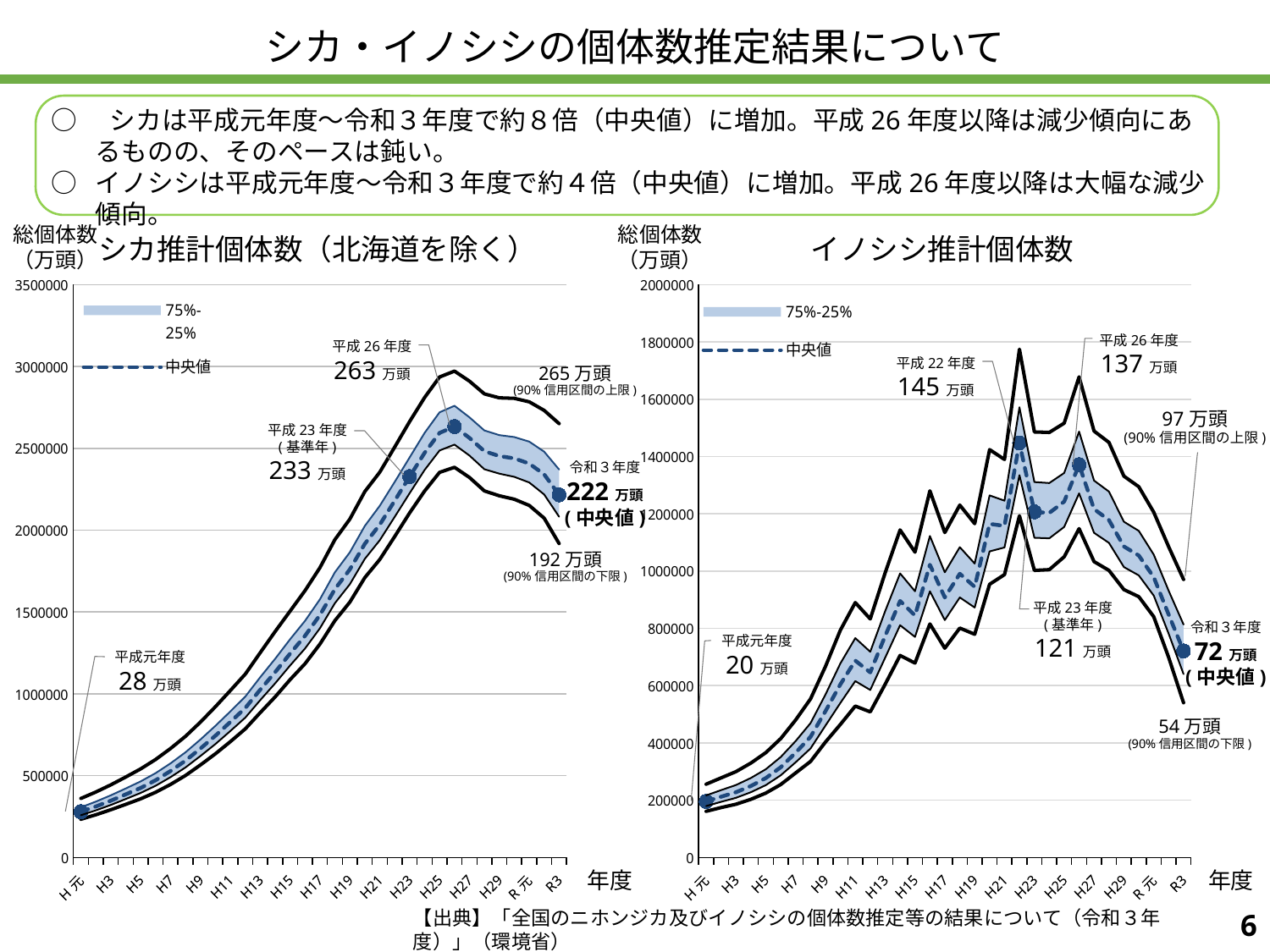
In the シカ推計個体数（北海道を除く） chart, what is the labelled median value for 平成26年度? 263 万頭 How many entries does the legend of the シカ推計個体数（北海道を除く） chart list? 2 What kind of chart is the イノシシ推計個体数 chart? Combination line and area chart (lines with a shaded 75%-25% band) In the イノシシ推計個体数 chart, what is the labelled lower limit of the 90% credible interval for 令和3年度? 54 万頭 In the イノシシ推計個体数 chart, which labelled year has the larger median value, 平成23年度 or 平成26年度? 平成26年度 In the イノシシ推計個体数 chart, what is the labelled median value for 平成22年度? 145 万頭 In the イノシシ推計個体数 chart, what is the labelled median value for 令和3年度? 72 万頭 In the イノシシ推計個体数 chart, what is the difference between the labelled median values for 平成22年度 and 平成23年度? 24 万頭 In the シカ推計個体数（北海道を除く） chart, what is the labelled value for 平成元年度? 28 万頭 In the シカ推計個体数（北海道を除く） chart, what is the labelled upper limit of the 90% credible interval for 令和3年度? 265 万頭 In the シカ推計個体数（北海道を除く） chart, what is the labelled median value for 令和3年度? 222 万頭 In the シカ推計個体数（北海道を除く） chart, what is the difference between the labelled median values for 平成26年度 and 令和3年度? 41 万頭